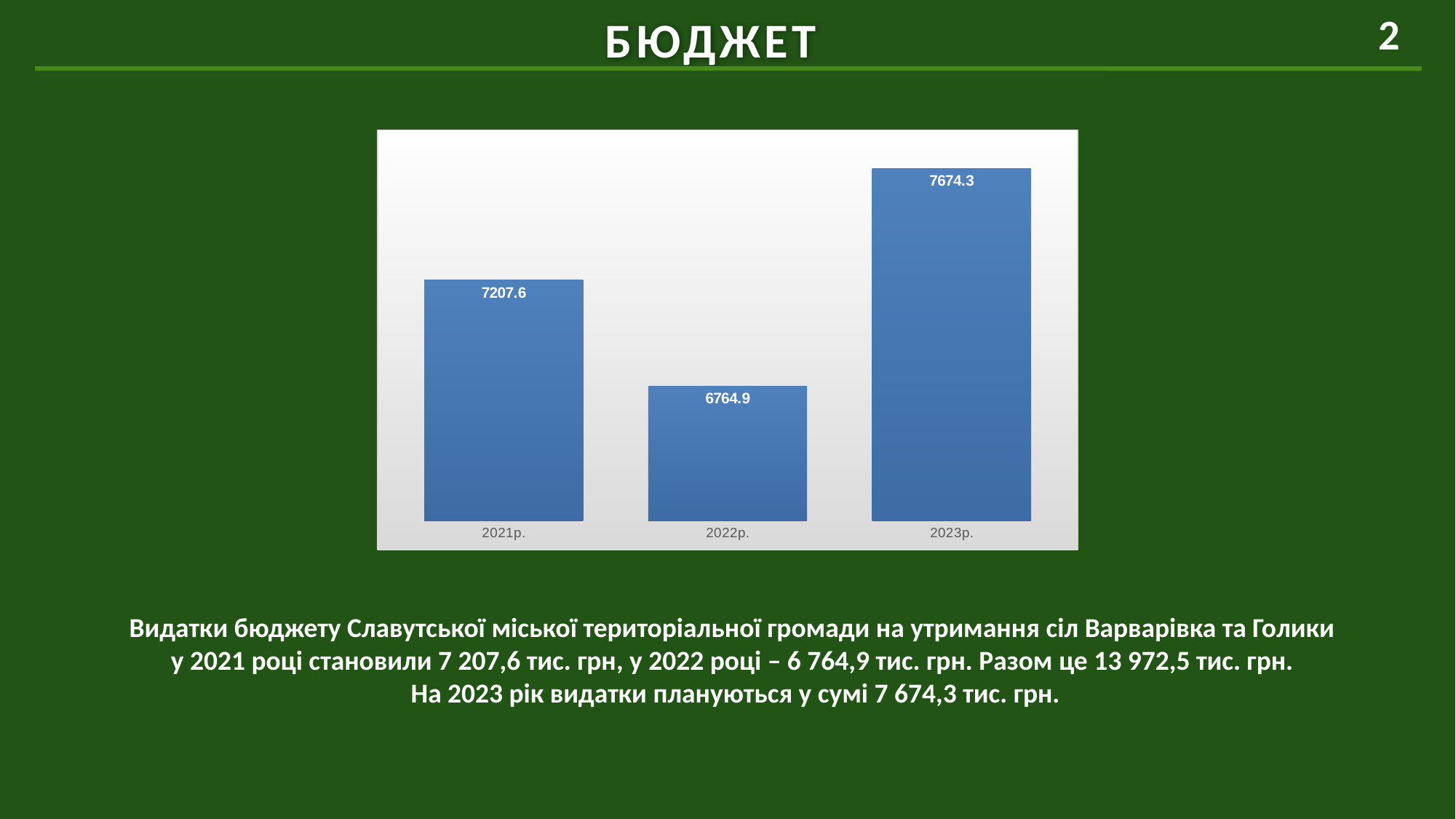
What is the value shown for 2023р.? 7674.3 What is the difference between the values for 2021р. and 2022р.? 442.7 Which year has the highest value in the chart? 2023р. What kind of chart is shown on the slide? Bar chart What is the value shown for 2022р.? 6764.9 What is the value shown for 2021р.? 7207.6 What is the difference between the values for 2023р. and 2022р.? 909.4 What is the difference between the values for 2023р. and 2021р.? 466.7 Which year has the lowest value in the chart? 2022р. Which is larger, the value for 2021р. or the value for 2022р.? 2021р. Does the value rise or fall from 2022р. to 2023р.? Rise How many bars are shown in the chart? 3